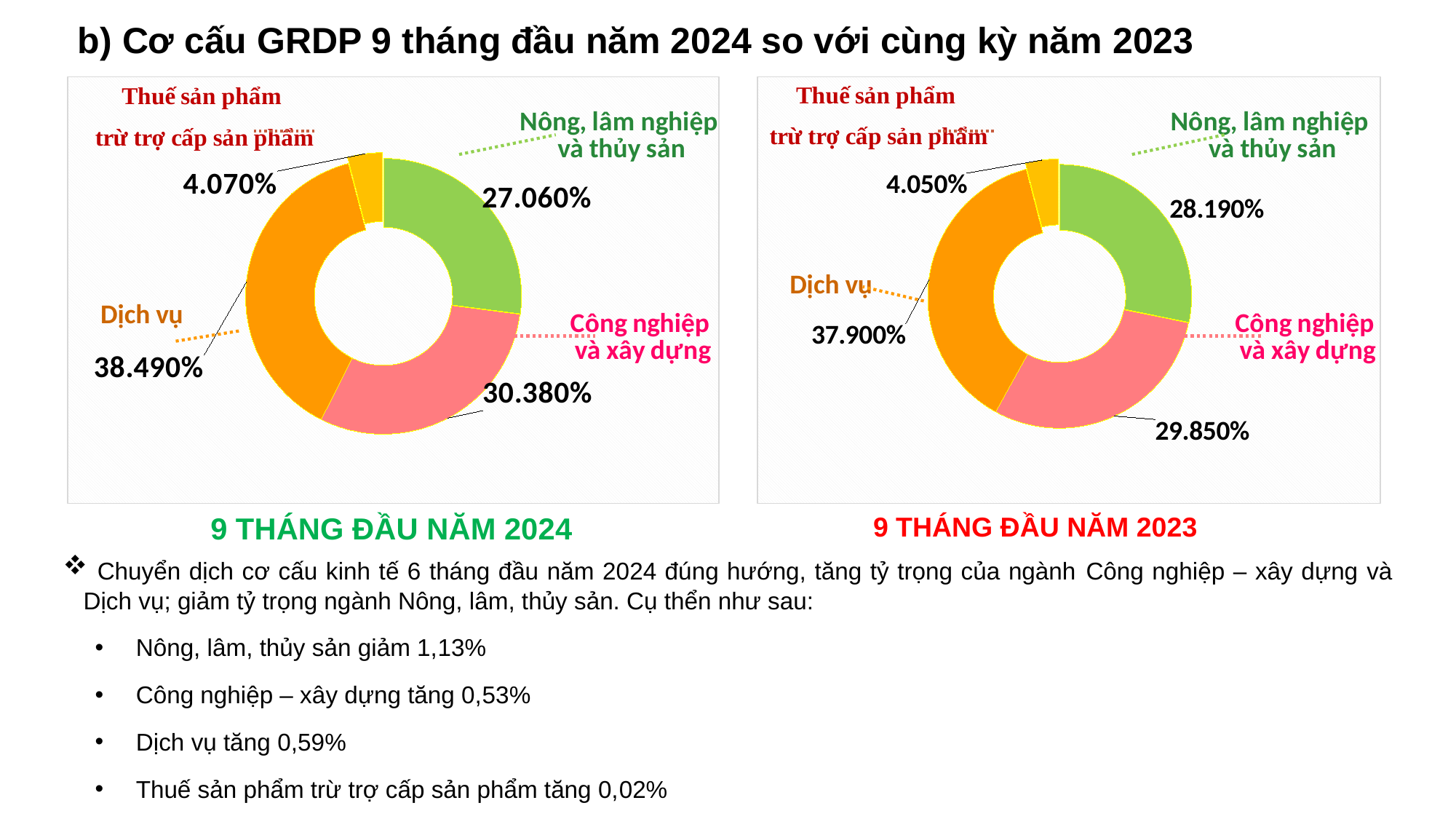
In the '9 THÁNG ĐẦU NĂM 2024' chart, what is the share for Thuế sản phẩm trừ trợ cấp sản phẩm? 4.070% In the '9 THÁNG ĐẦU NĂM 2023' chart, what is the share for Nông, lâm nghiệp và thủy sản? 28.190% In the '9 THÁNG ĐẦU NĂM 2024' chart, what is the difference between the shares of Dịch vụ and Công nghiệp và xây dựng? 8.110% In the '9 THÁNG ĐẦU NĂM 2023' chart, what is the share for Công nghiệp và xây dựng? 29.850% How many categories are shown in the '9 THÁNG ĐẦU NĂM 2024' chart? 4 In the '9 THÁNG ĐẦU NĂM 2024' chart, what is the share for Dịch vụ? 38.490% In the '9 THÁNG ĐẦU NĂM 2024' chart, which category has the largest share? Dịch vụ What type of chart is used for '9 THÁNG ĐẦU NĂM 2023'? Doughnut (pie) chart In the '9 THÁNG ĐẦU NĂM 2023' chart, which category has the smallest share? Thuế sản phẩm trừ trợ cấp sản phẩm What is the difference between the Dịch vụ share in the 2024 chart and the Dịch vụ share in the 2023 chart? 0.590% In the '9 THÁNG ĐẦU NĂM 2024' chart, what colour is the Dịch vụ slice? Orange In the '9 THÁNG ĐẦU NĂM 2023' chart, which is larger: Nông, lâm nghiệp và thủy sản or Công nghiệp và xây dựng? Công nghiệp và xây dựng